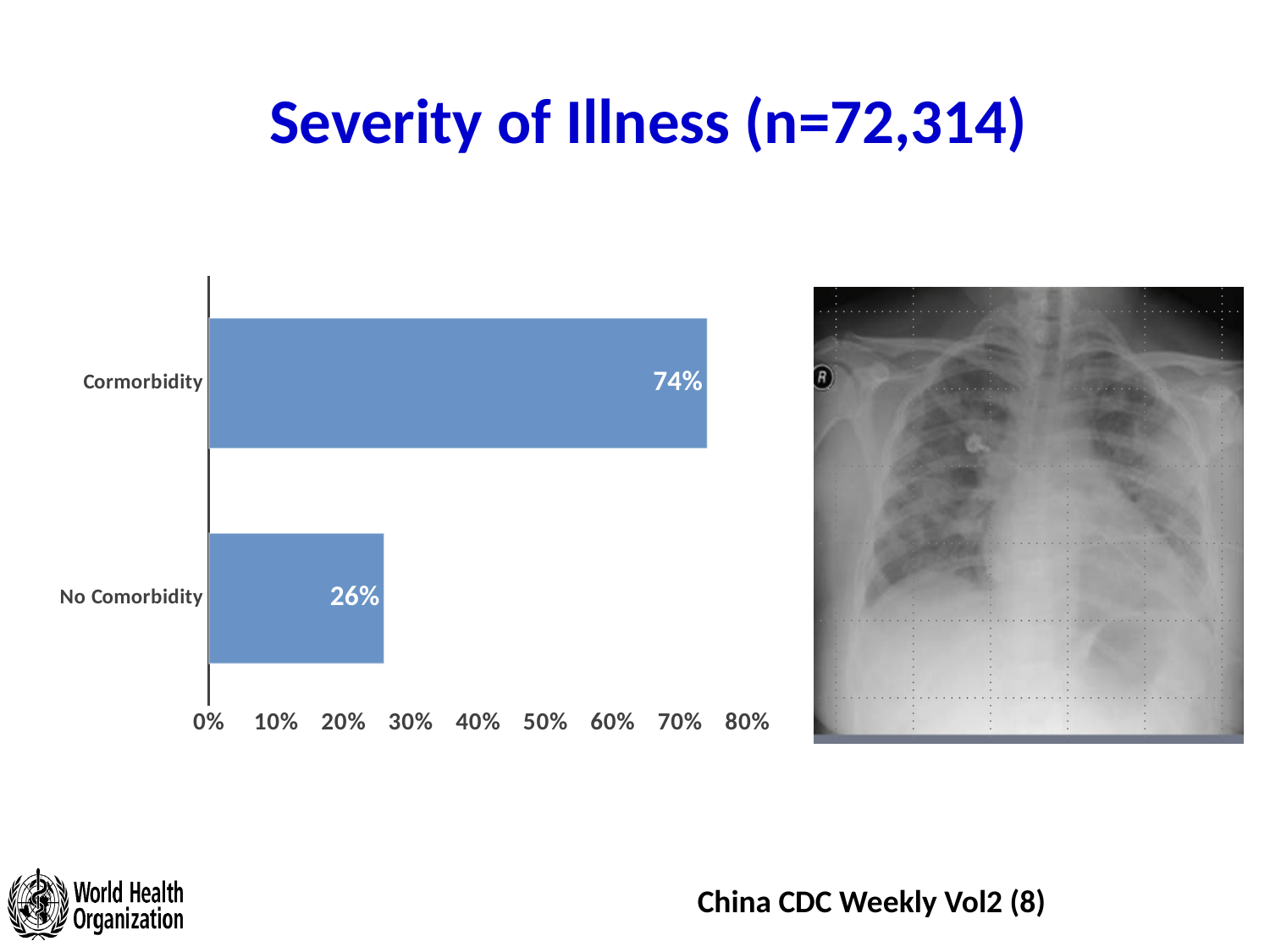
Which is larger, the value for Cormorbidity or the value for No Comorbidity? Cormorbidity Which category has the lowest value? No Comorbidity What kind of chart is shown on the slide? bar chart What is the difference between the values for Cormorbidity and No Comorbidity? 48% Which category has the highest value? Cormorbidity What is the value for No Comorbidity? 26% Is the value for Cormorbidity greater or less than 50%? greater How many categories are shown in the chart? 2 What is the highest value shown on the x axis of the chart? 80% What is the title of the slide containing the chart? Severity of Illness (n=72,314) Is the value for No Comorbidity greater or less than 30%? less What is the value for Cormorbidity? 74%